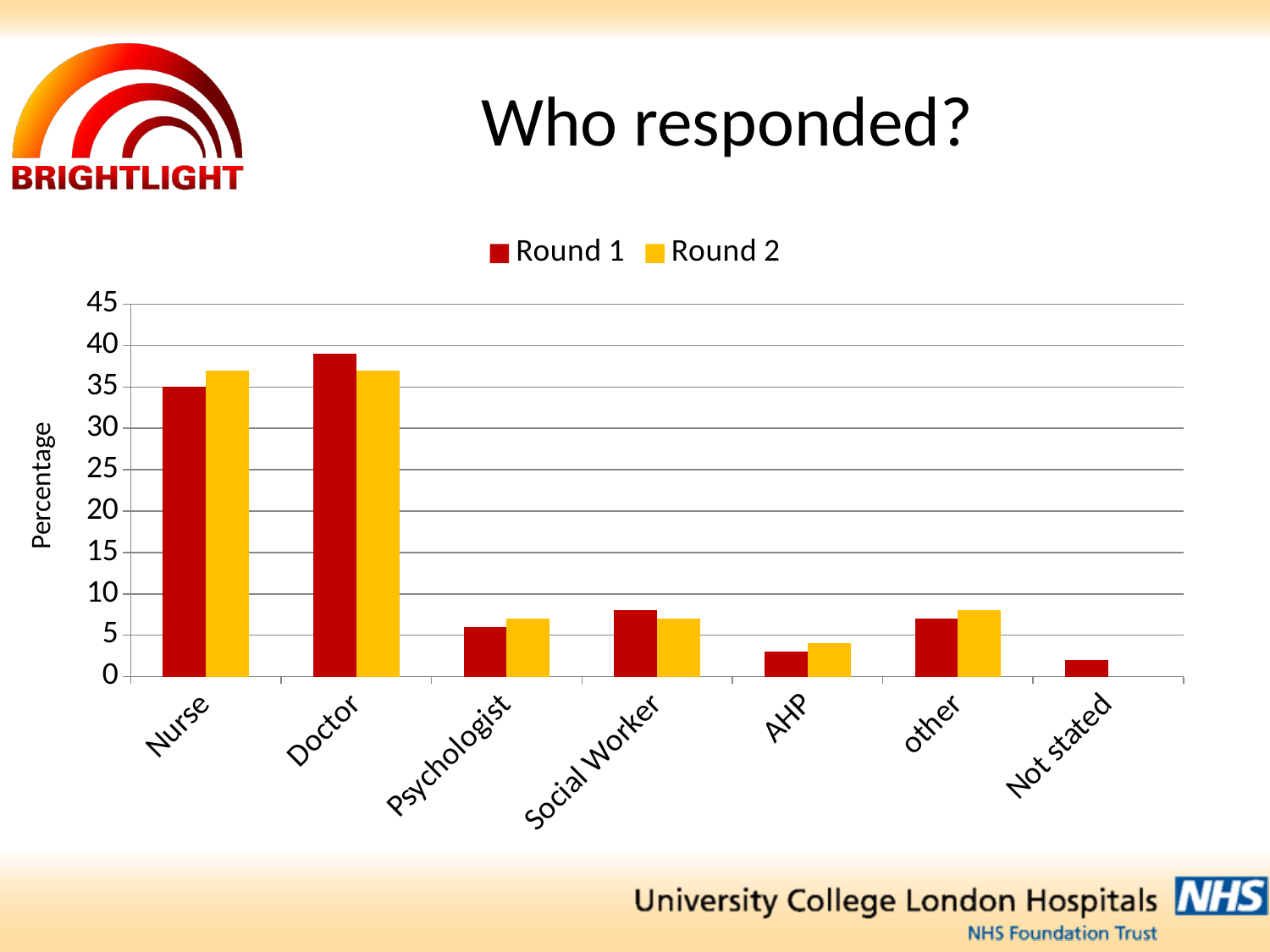
Which category has the lowest Round 2 value? AHP For Doctor, which is larger: the Round 1 value or the Round 2 value? Round 1 Is the Round 1 value for Doctor greater or less than 35? greater What is the label on the vertical axis? Percentage Is the Round 1 value for Social Worker greater or less than 5? greater How many categories are shown on the x axis? 7 For Nurse, which is larger: the Round 1 value or the Round 2 value? Round 2 Which category has the lowest Round 1 value? Not stated Is the Round 1 value for AHP greater or less than 5? less Which category has the highest Round 1 value? Doctor What type of chart is shown on the slide? bar chart How many series does the legend list? 2